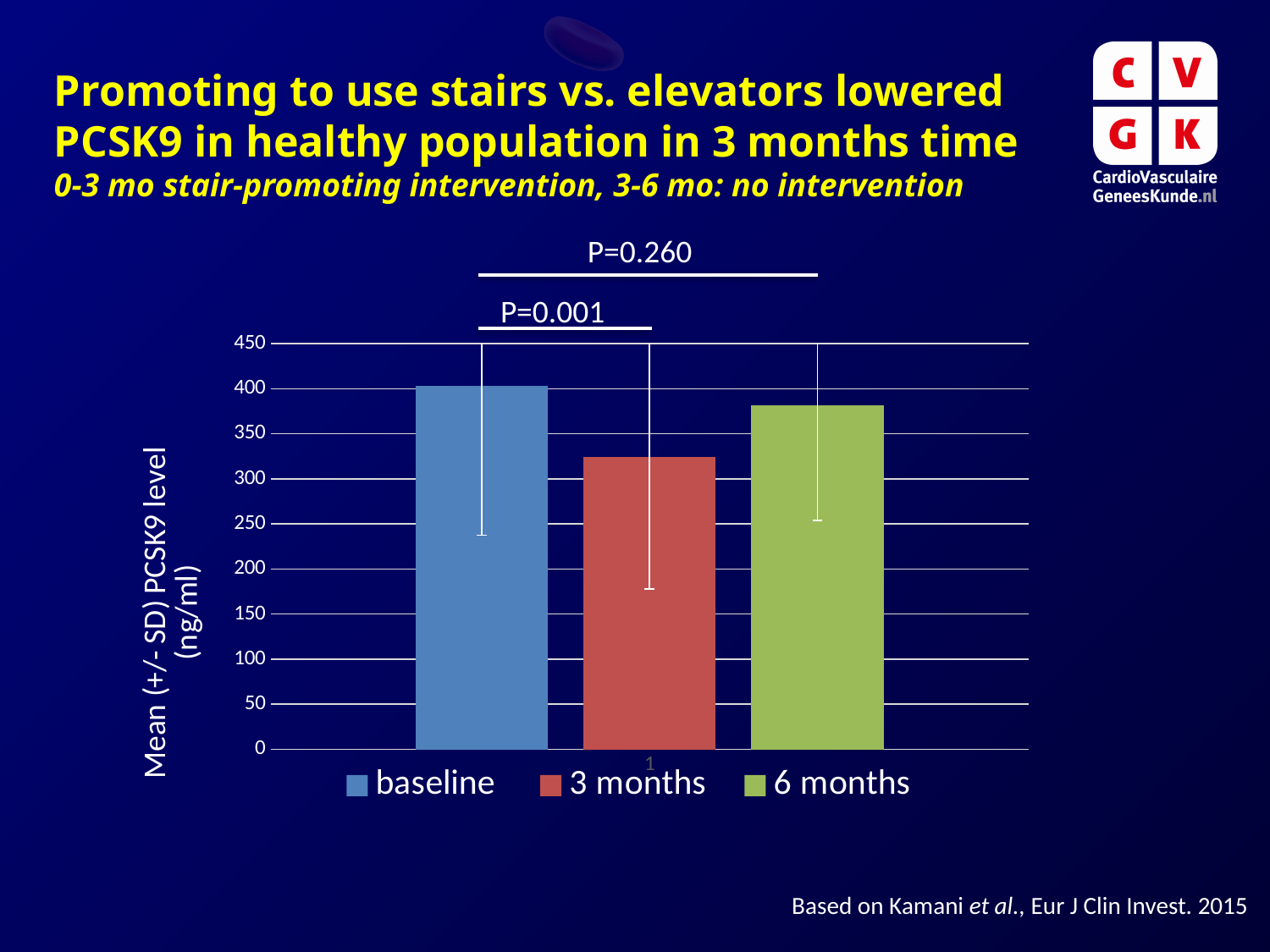
How many bars are plotted in the chart? 3 Is the mean PCSK9 level at 3 months greater or less than 350? less What kind of chart is shown on the slide? bar chart How many series does the legend list? 3 Which series has the highest mean PCSK9 level? baseline Is the mean PCSK9 level at 6 months greater or less than 400? less Which series has the lowest mean PCSK9 level? 3 months Which is larger, the mean PCSK9 level at 3 months or at 6 months? 6 months Which is larger, the mean PCSK9 level at baseline or at 6 months? baseline What P value is shown for the comparison between baseline and 3 months? P=0.001 What is the label of the vertical axis? Mean (+/- SD) PCSK9 level (ng/ml) Is the mean PCSK9 level at baseline greater or less than 350? greater